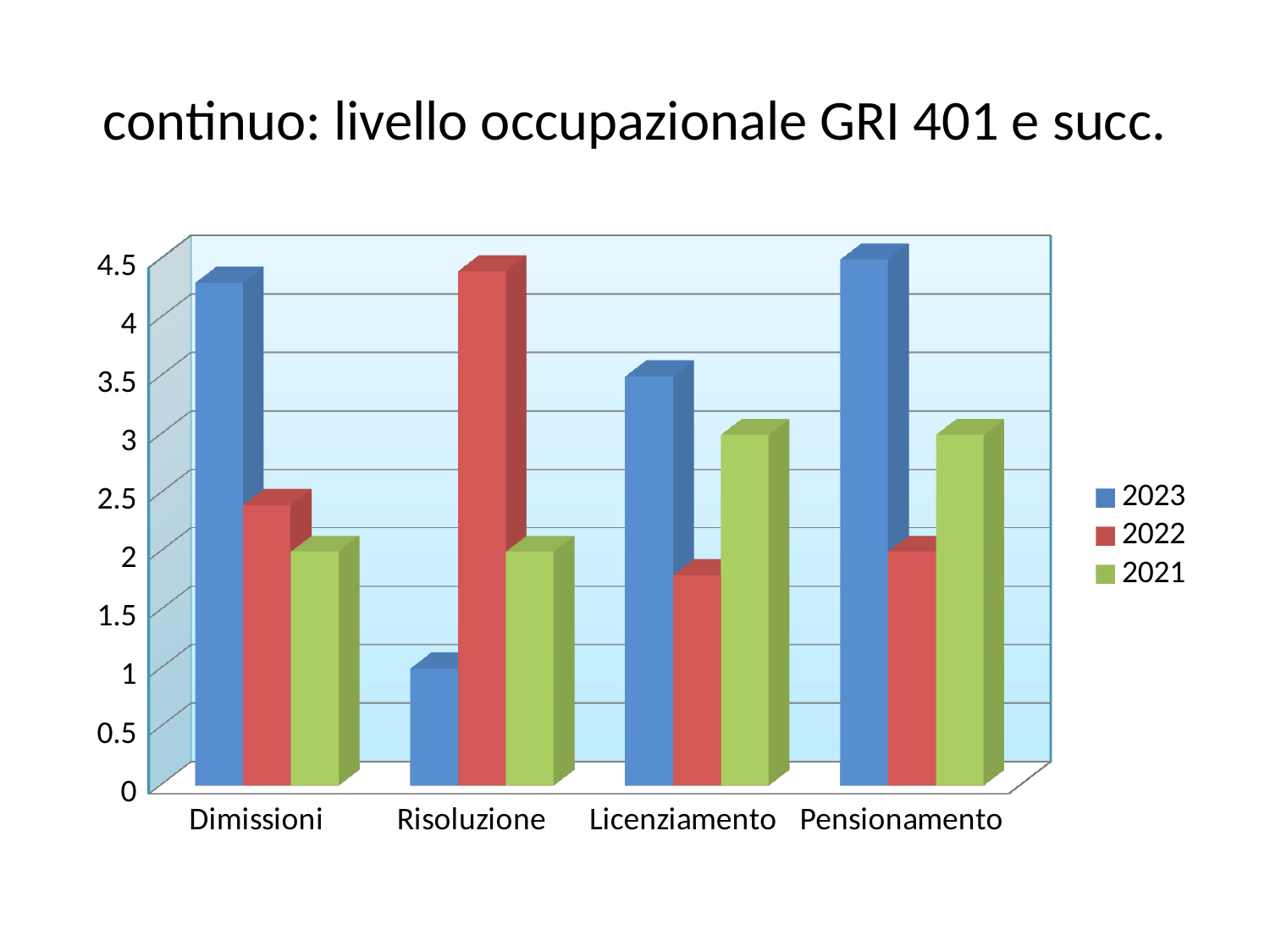
How many series does the legend list? 3 For Licenziamento, which series has the larger value, 2023 or 2021? 2023 What kind of chart is shown on the slide? bar chart Which colour represents the 2021 series in the legend? green How many categories are shown on the x axis of the chart? 4 Is the 2022 value for Risoluzione greater or less than 4? greater Is the 2023 value for Risoluzione greater or less than 1.5? less Is the 2023 value for Dimissioni greater or less than 4? greater For Dimissioni, which series has the larger value, 2023 or 2022? 2023 Which category has the lowest value for the 2023 series? Risoluzione Which category has the highest value for the 2022 series? Risoluzione